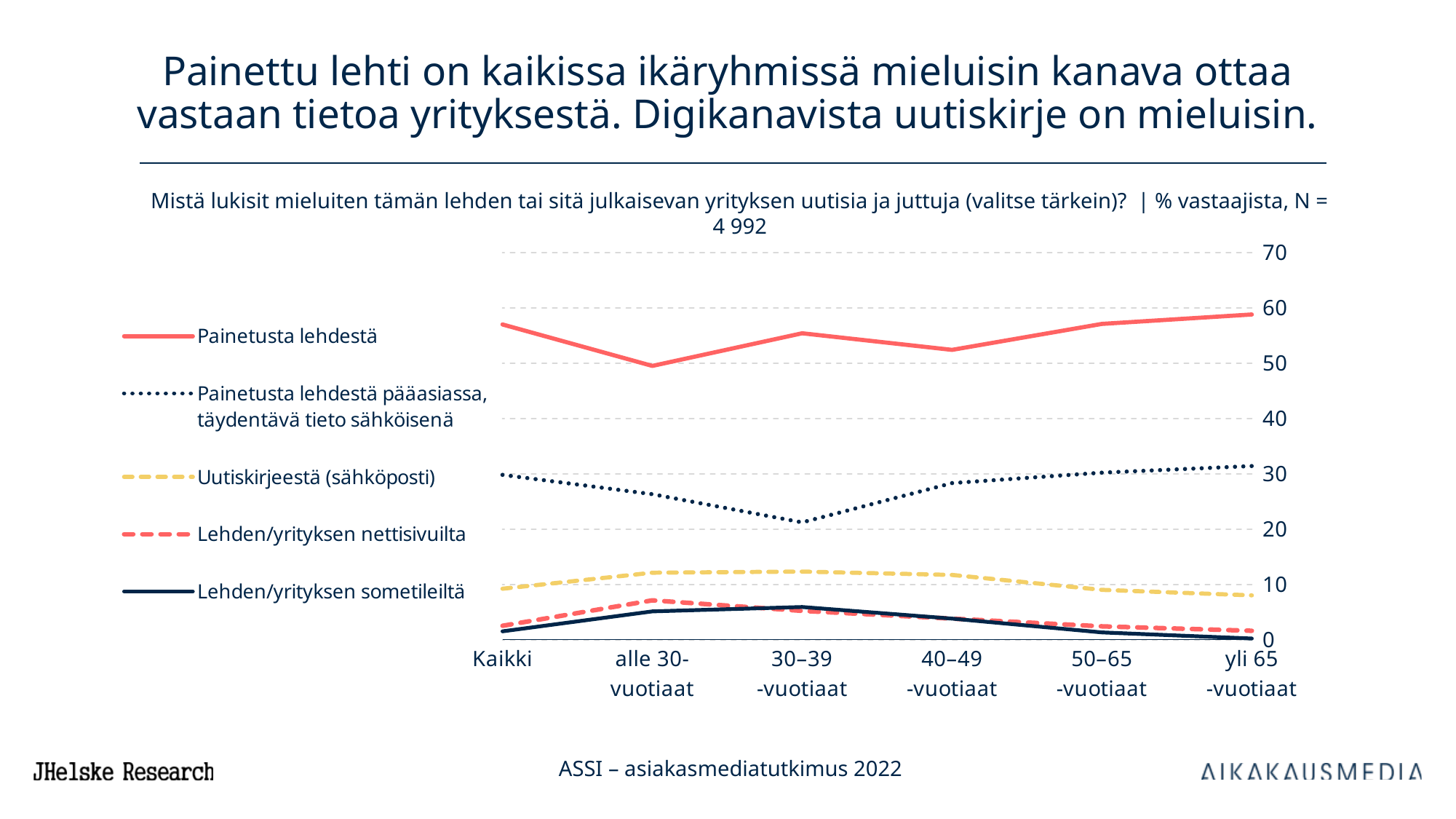
Is the value for 'Uutiskirjeestä (sähköposti)' for yli 65-vuotiaat greater or less than 10? less Is the value for 'Lehden/yrityksen sometileiltä' for yli 65-vuotiaat greater or less than 10? less In the Kaikki category, which is larger: 'Painetusta lehdestä' or 'Uutiskirjeestä (sähköposti)'? Painetusta lehdestä For which category is the value of 'Painetusta lehdestä' lowest? alle 30-vuotiaat Which series is drawn with a yellow dashed line? Uutiskirjeestä (sähköposti) For which category is the value of 'Painetusta lehdestä pääasiassa, täydentävä tieto sähköisenä' lowest? 30–39-vuotiaat How many series does the legend list? 5 Is the value for 'Painetusta lehdestä' in the Kaikki category greater or less than 50? greater Does the value for 'Lehden/yrityksen sometileiltä' rise or fall from 30–39-vuotiaat to yli 65-vuotiaat? fall How many age-group categories are shown along the x axis? 6 What kind of chart is shown on the slide? line chart